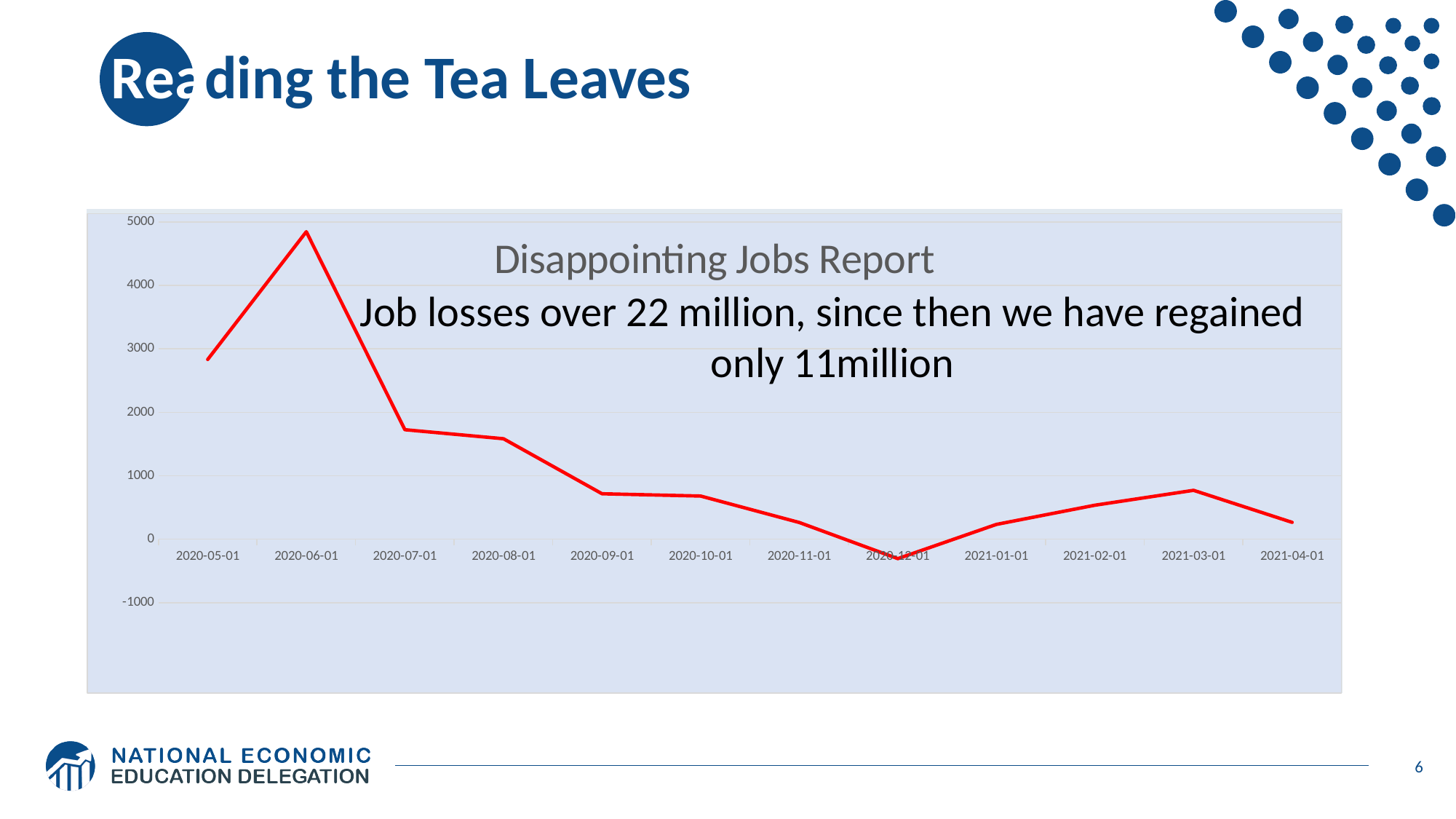
What kind of chart is shown on the slide? line chart What is the title of the chart? Disappointing Jobs Report Which date has the lowest value on the chart? 2020-12-01 Is the value for 2021-03-01 greater or less than 1000? less Is the value for 2020-06-01 greater or less than 4000? greater Which date has the highest value on the chart? 2020-06-01 Do the values rise or fall between 2020-06-01 and 2020-12-01? fall Is the value for 2020-09-01 greater or less than 1000? less Which has the larger value, 2020-07-01 or 2021-03-01? 2020-07-01 How many dates are plotted along the x axis of the chart? 12